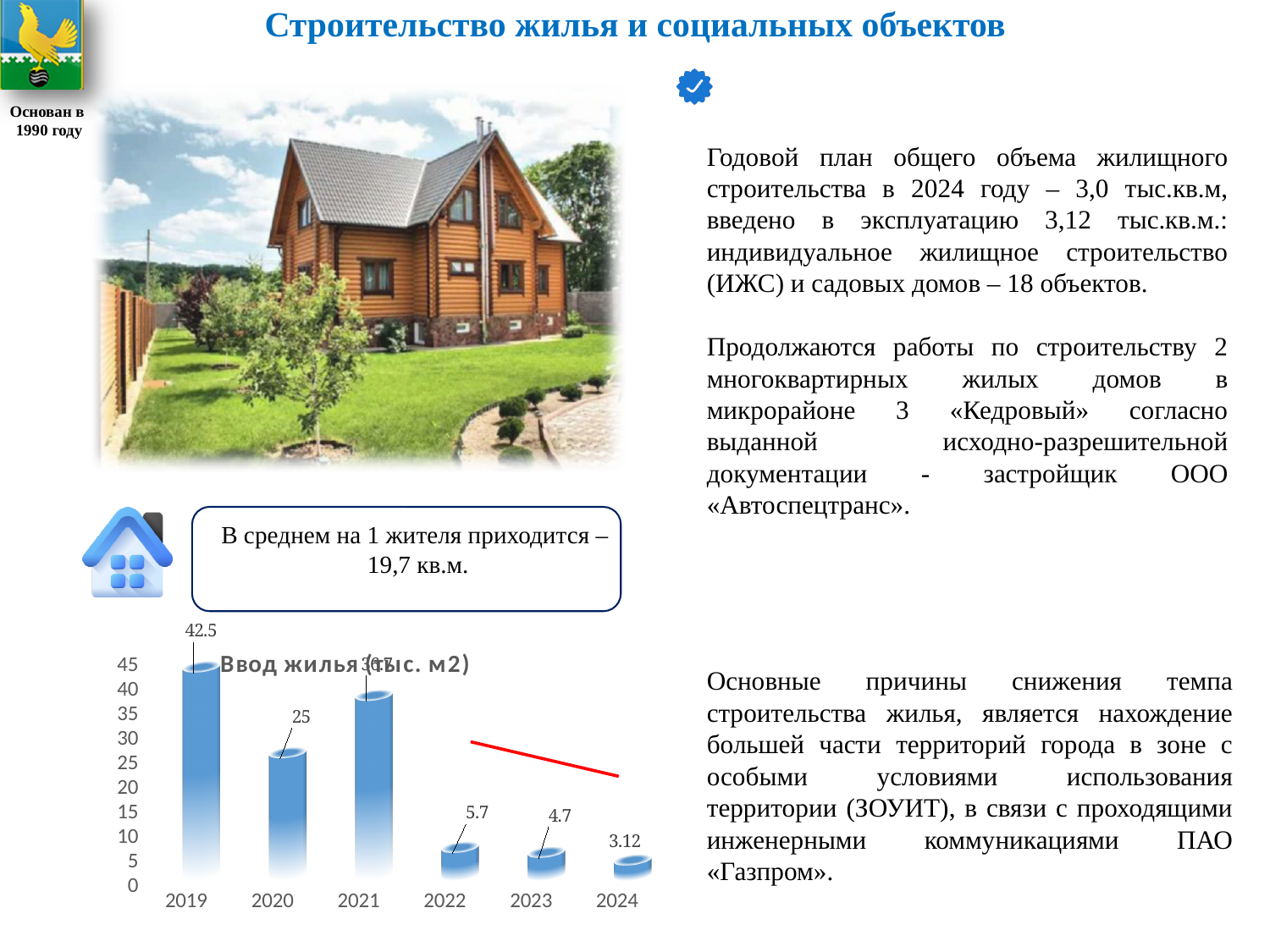
Do the values in the chart generally rise or fall from 2019 to 2024? fall How many years are shown on the x axis of the chart? 6 What is the difference between the values for 2019 and 2020? 17.5 Which year has the highest value in the chart? 2019 Which year has the lowest value in the chart? 2024 What is the value for 2019 in the chart 'Ввод жилья (тыс. м2)'? 42.5 What is the value for 2020 in the chart? 25 What is the value for 2024 in the chart? 3.12 Which is larger, the value for 2020 or the value for 2021? 2021 Is the value for 2021 greater or less than 30? greater What is the value for 2022 in the chart? 5.7 What is the value for 2023 in the chart? 4.7